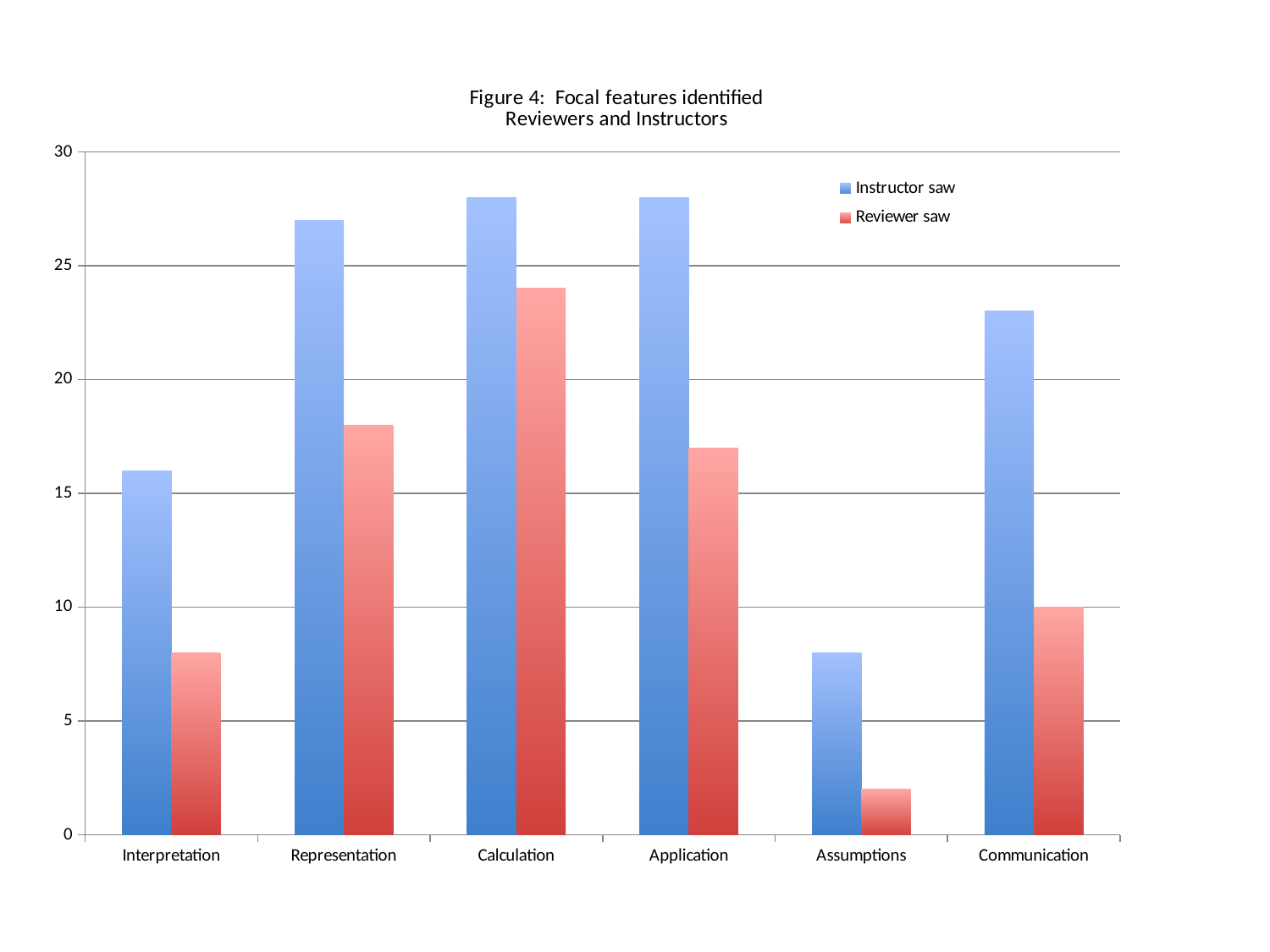
Which category has the lowest value for the 'Instructor saw' series? Assumptions Which category has the lowest value for the 'Reviewer saw' series? Assumptions For Representation, which series has the larger value, 'Instructor saw' or 'Reviewer saw'? Instructor saw What kind of chart is shown on the slide? bar chart How many series does the legend list? 2 Is the 'Reviewer saw' value for Representation greater or less than 20? less Which category has the highest value for the 'Reviewer saw' series? Calculation Is the 'Instructor saw' value for Assumptions greater or less than 10? less Is the 'Instructor saw' value for Interpretation greater or less than 15? greater What is the title of the chart? Figure 4: Focal features identified Reviewers and Instructors How many categories are shown on the x axis? 6